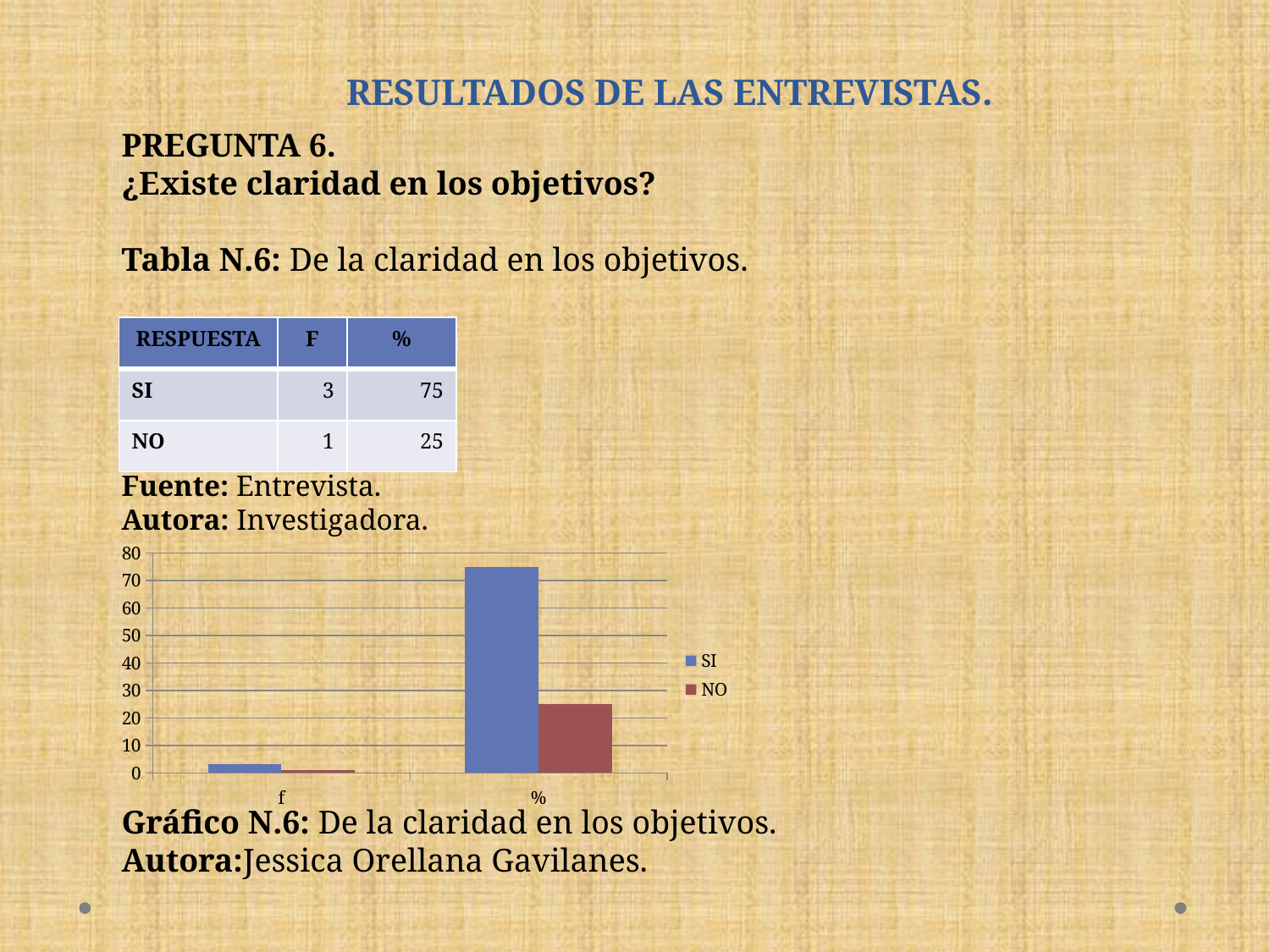
Is the value for SI in the f category greater or less than 10? less What is the value for SI in the % category? 75 Which series is higher in the % category, SI or NO? SI What is the difference between the SI and NO values in the % category? 50 What is the value for NO in the % category? 25 Which series is shown in blue in the chart legend? SI How many categories are shown on the x axis of the chart? 2 Is the value for SI in the % category greater or less than 70? greater How many series does the chart legend list? 2 What kind of chart is shown on the slide? bar chart Is the value for NO in the % category greater or less than 30? less What are the two category labels on the x axis of the chart? f and %